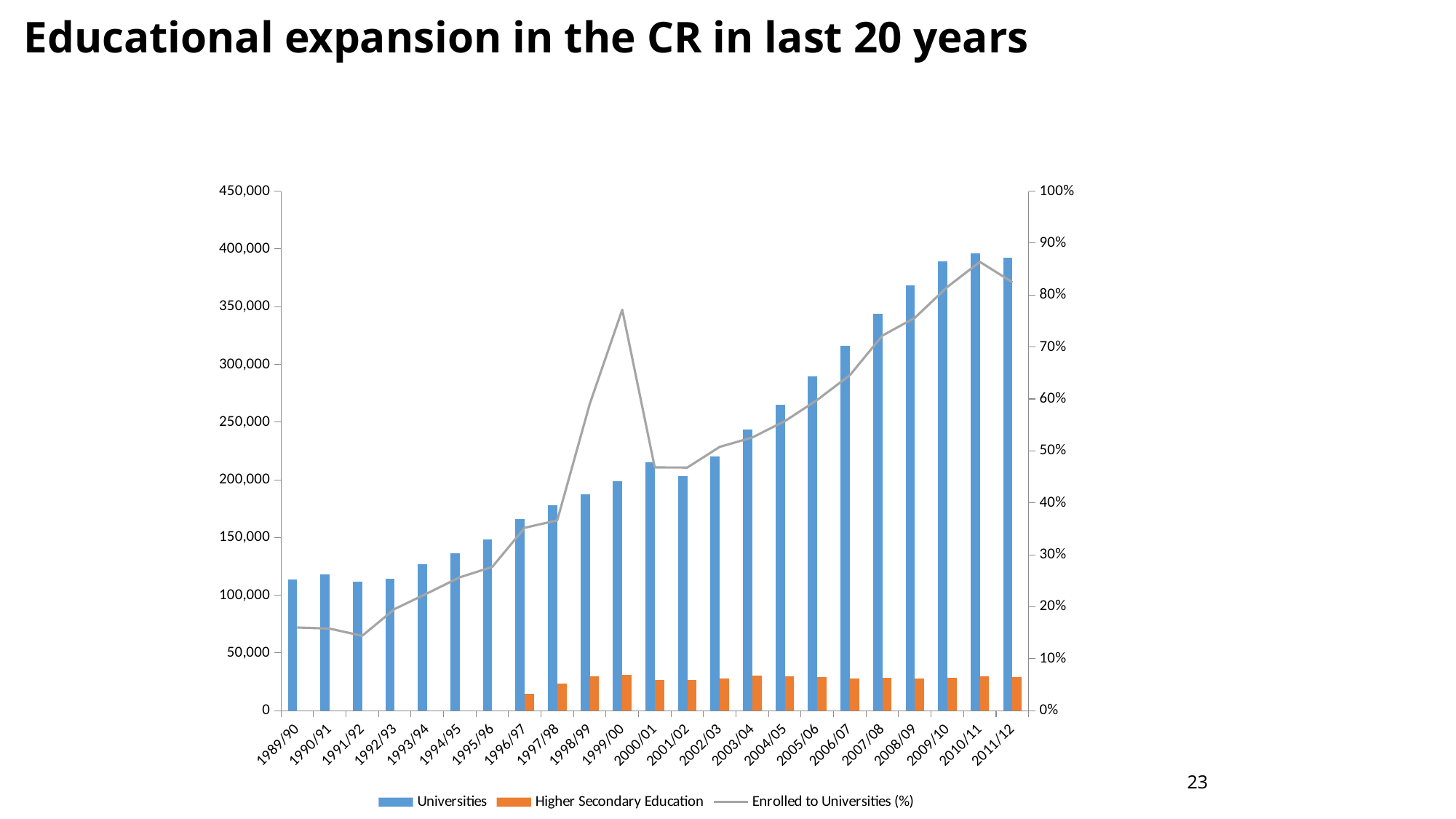
How many academic years are shown on the x axis? 23 How many series does the legend list? 3 What kind of chart is this? Combination bar and line chart Is the Enrolled to Universities (%) value for 1989/90 greater or less than 20%? less Is the Universities value for 2010/11 greater or less than 350,000? greater Which academic year has the highest value for Enrolled to Universities (%)? 2010/11 Which is larger, the Universities value for 2005/06 or for 2000/01? 2005/06 Do the Universities values generally rise or fall from 1989/90 to 2010/11? rise Is the Enrolled to Universities (%) value for 1999/00 greater or less than 70%? greater What is the name of the series plotted as a line? Enrolled to Universities (%)